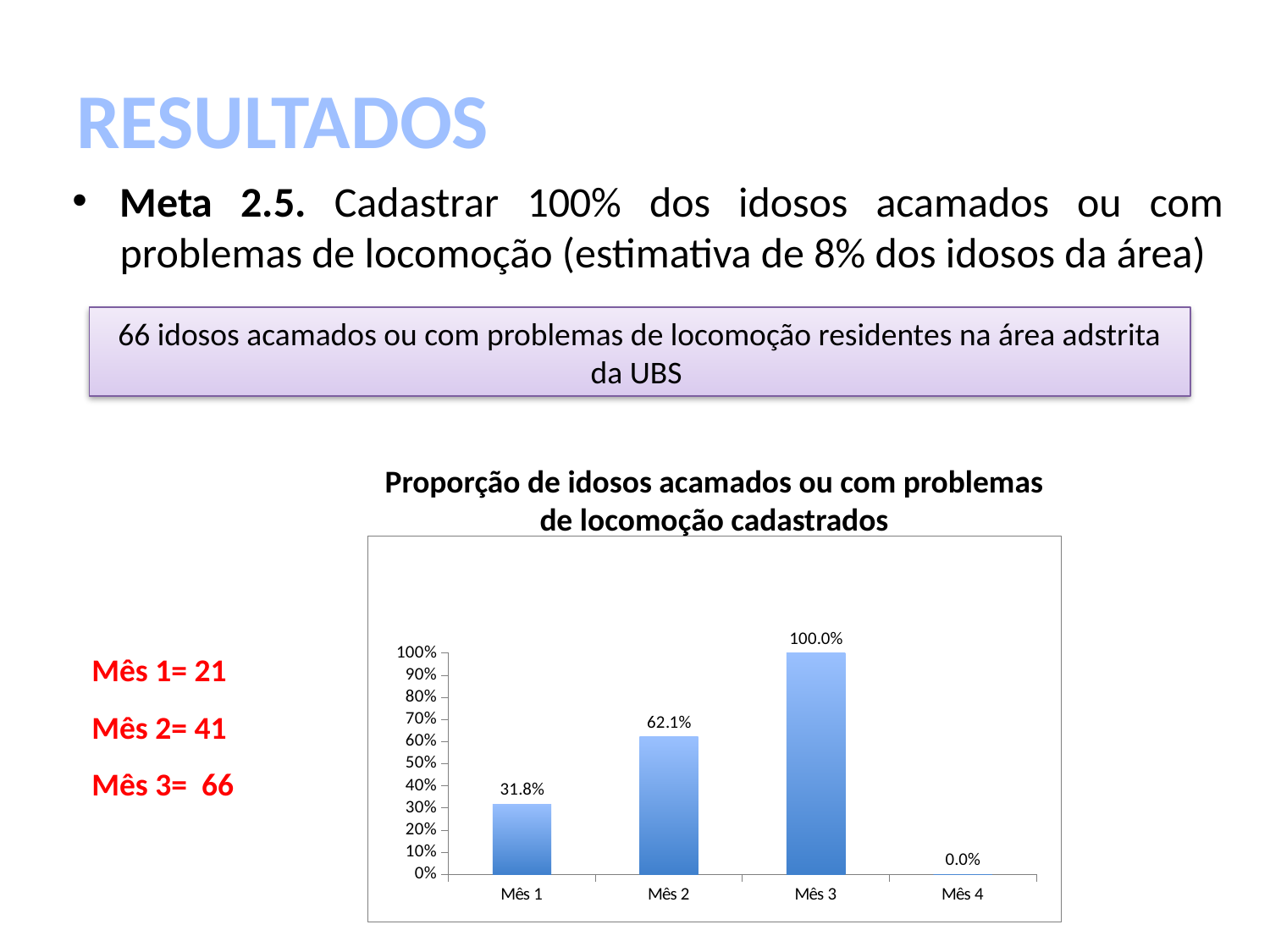
Is the value for Mês 2 greater or less than 50%? greater What is the value for Mês 4? 0.0% Which is larger, the value for Mês 1 or the value for Mês 2? Mês 2 What is the value for Mês 1? 31.8% What kind of chart is shown? bar chart Which month has the lowest value? Mês 4 What is the value for Mês 2? 62.1% What is the title of the chart? Proporção de idosos acamados ou com problemas de locomoção cadastrados Which month has the highest value? Mês 3 How many months are shown on the x axis? 4 What is the difference between the values for Mês 2 and Mês 1? 30.3% What is the value for Mês 3? 100.0%